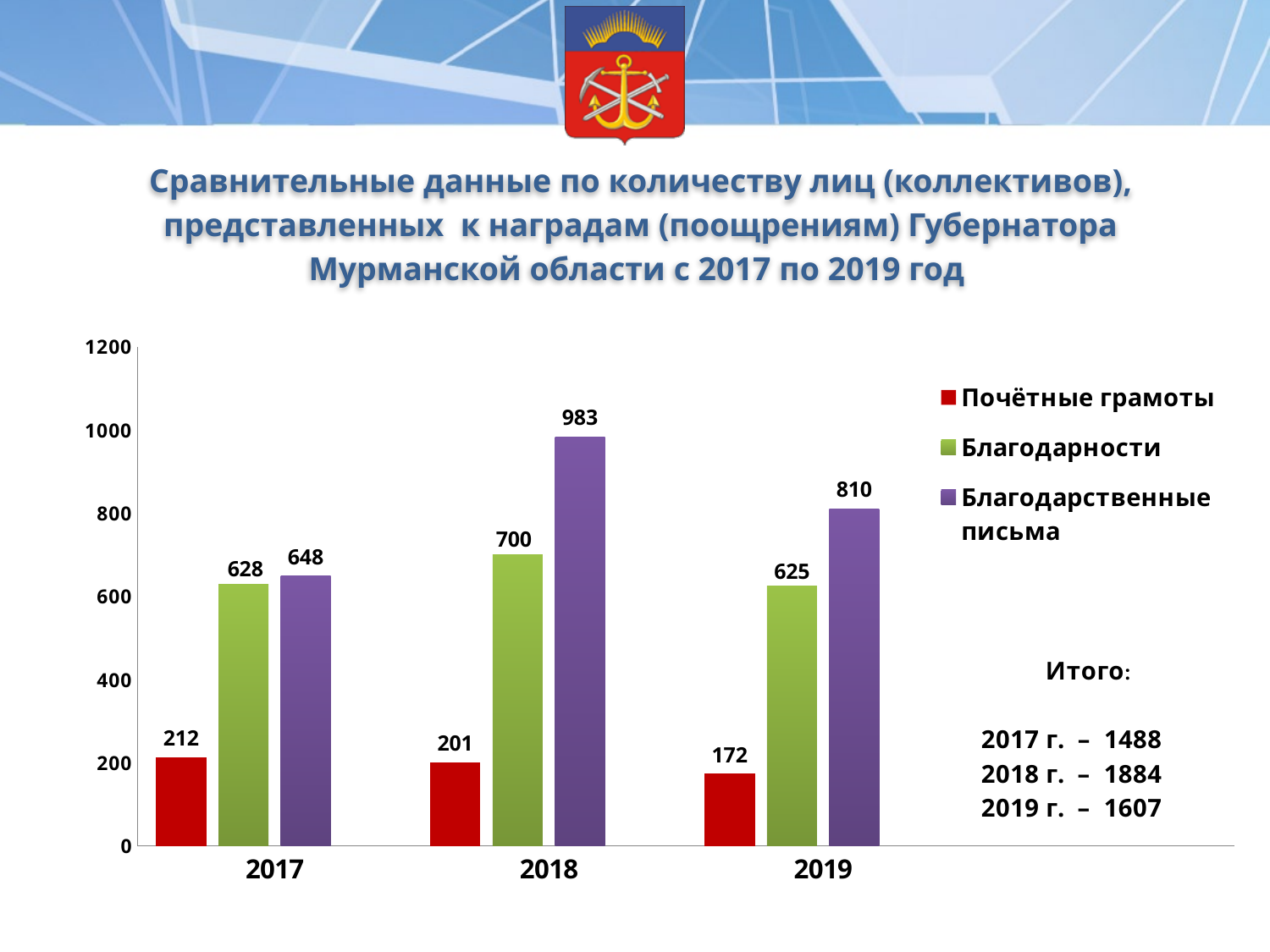
Which colour represents Почётные грамоты in the legend? red What is the value for Благодарности in 2017? 628 Is the value for Благодарственные письма in 2019 greater or less than 800? greater What is the value for Почётные грамоты in 2019? 172 What is the difference between Благодарственные письма in 2018 and in 2019? 173 In which year is the value for Почётные грамоты the lowest? 2019 How many years are shown on the x axis? 3 How many series does the legend list? 3 What is the value for Благодарственные письма in 2018? 983 What kind of chart is shown on the slide? bar chart In which year is the value for Благодарственные письма the highest? 2018 Which is larger: Благодарности in 2018 or Благодарности in 2019? Благодарности in 2018